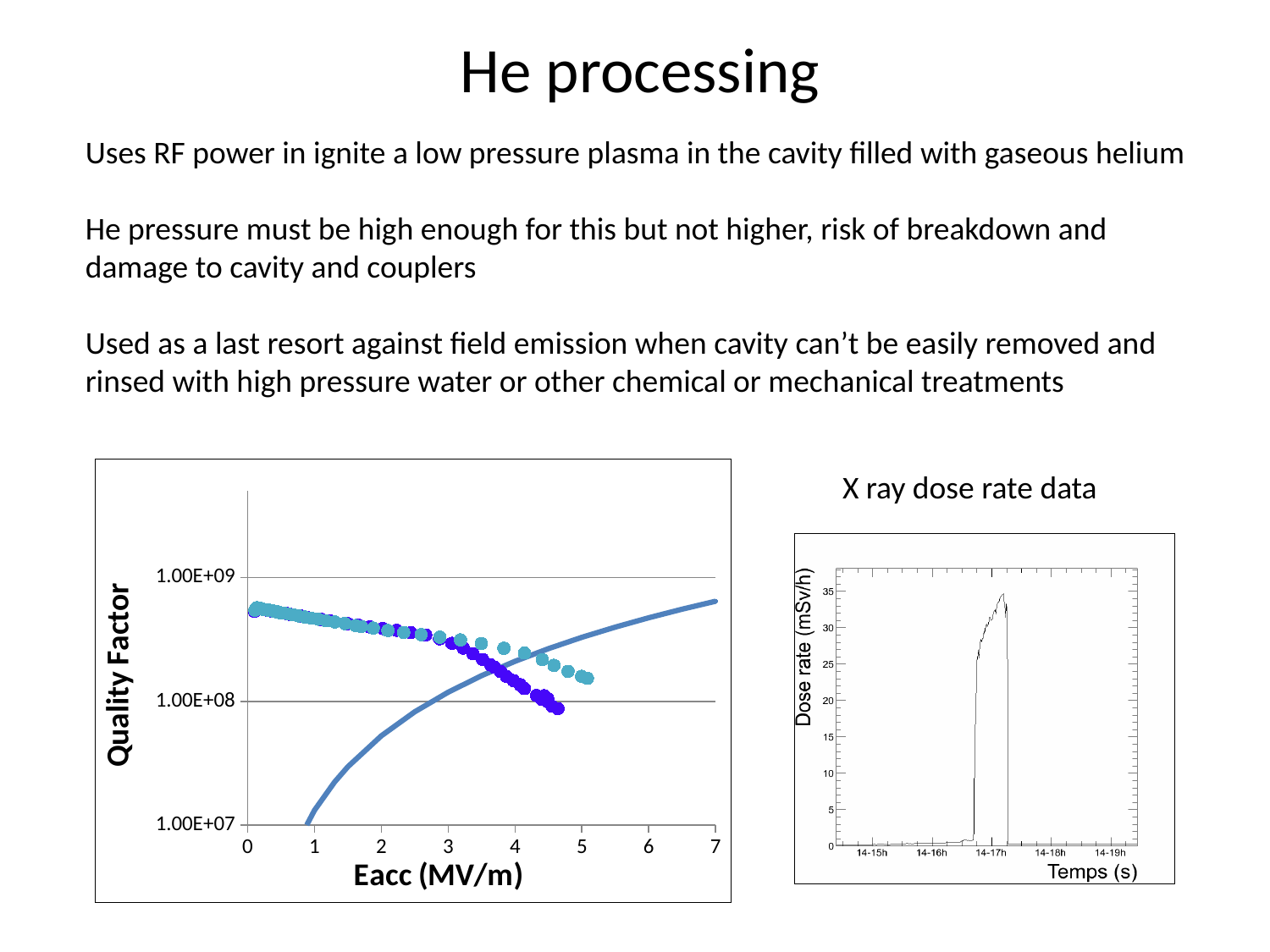
On the left chart, does the solid blue line rise or fall as Eacc increases? rise On the X ray dose rate data chart, is the peak dose rate greater or less than 30 mSv/h? greater On the left chart, do the dotted data points rise or fall as Eacc increases? fall What kind of chart is the left chart with Quality Factor on the y axis? scatter chart On the X ray dose rate data chart, what is the label of the x axis? Temps (s) On the left chart, is the Quality Factor of the dotted points at Eacc of 1 MV/m greater or less than 1.00E+09? less On the left chart, what is the label of the y axis? Quality Factor On the left chart, what is the highest value shown on the Eacc axis? 7 What kind of chart is the X ray dose rate data chart on the right? line chart On the X ray dose rate data chart, is the dose rate at 14-16h greater or less than 5 mSv/h? less